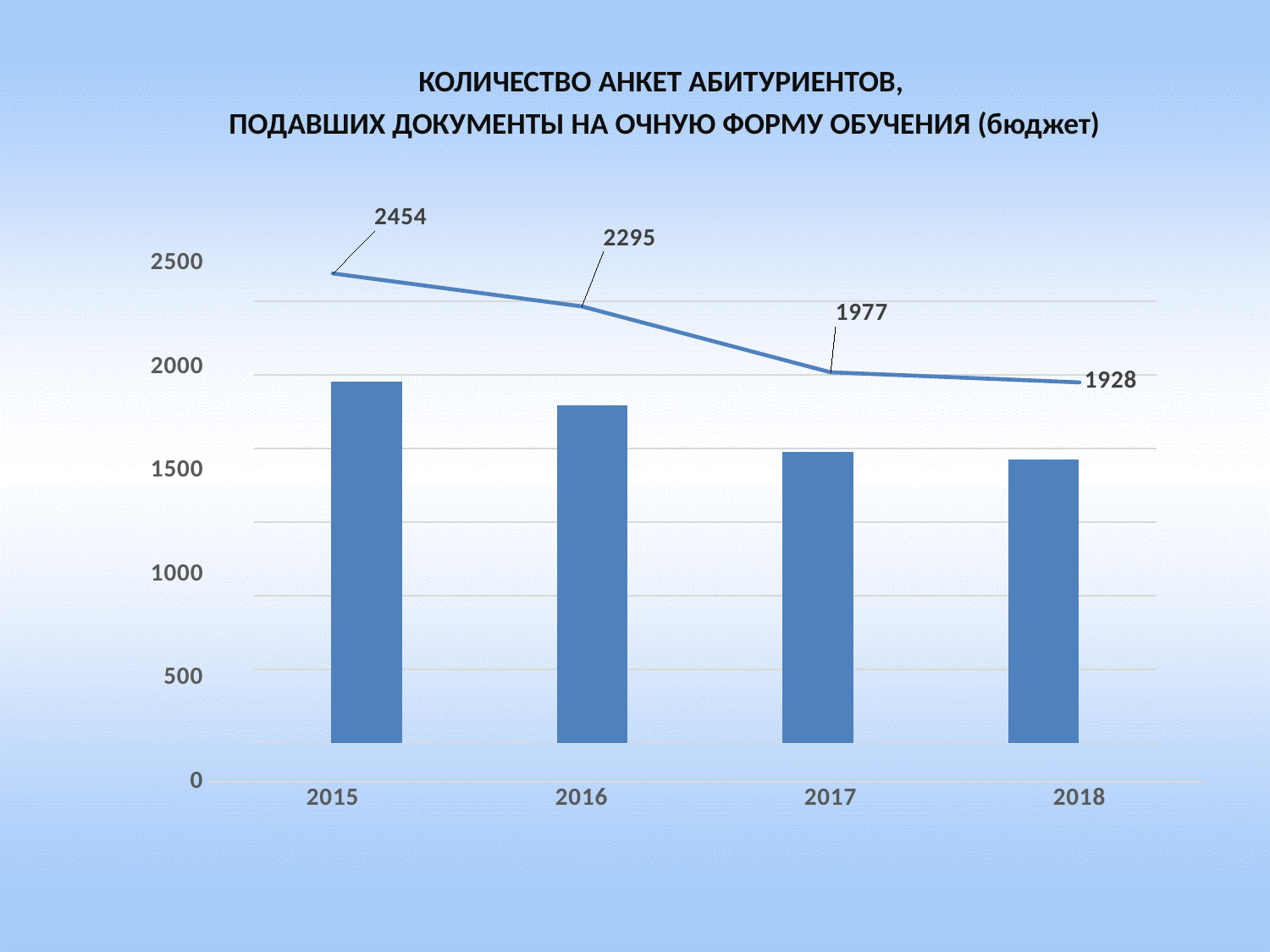
In which year does the line reach its highest value? 2015 What value does the line show for 2015? 2454 What is the difference between the line values for 2015 and 2016? 159 Which bar is taller, 2016 or 2017? 2016 Do the bar values rise or fall from 2015 to 2018? fall What is the difference between the line values for 2016 and 2018? 367 Is the bar for 2018 greater or less than 1500? greater In which year does the line reach its lowest value? 2018 How many years are shown on the x axis? 4 What value does the line show for 2018? 1928 What value does the line show for 2017? 1977